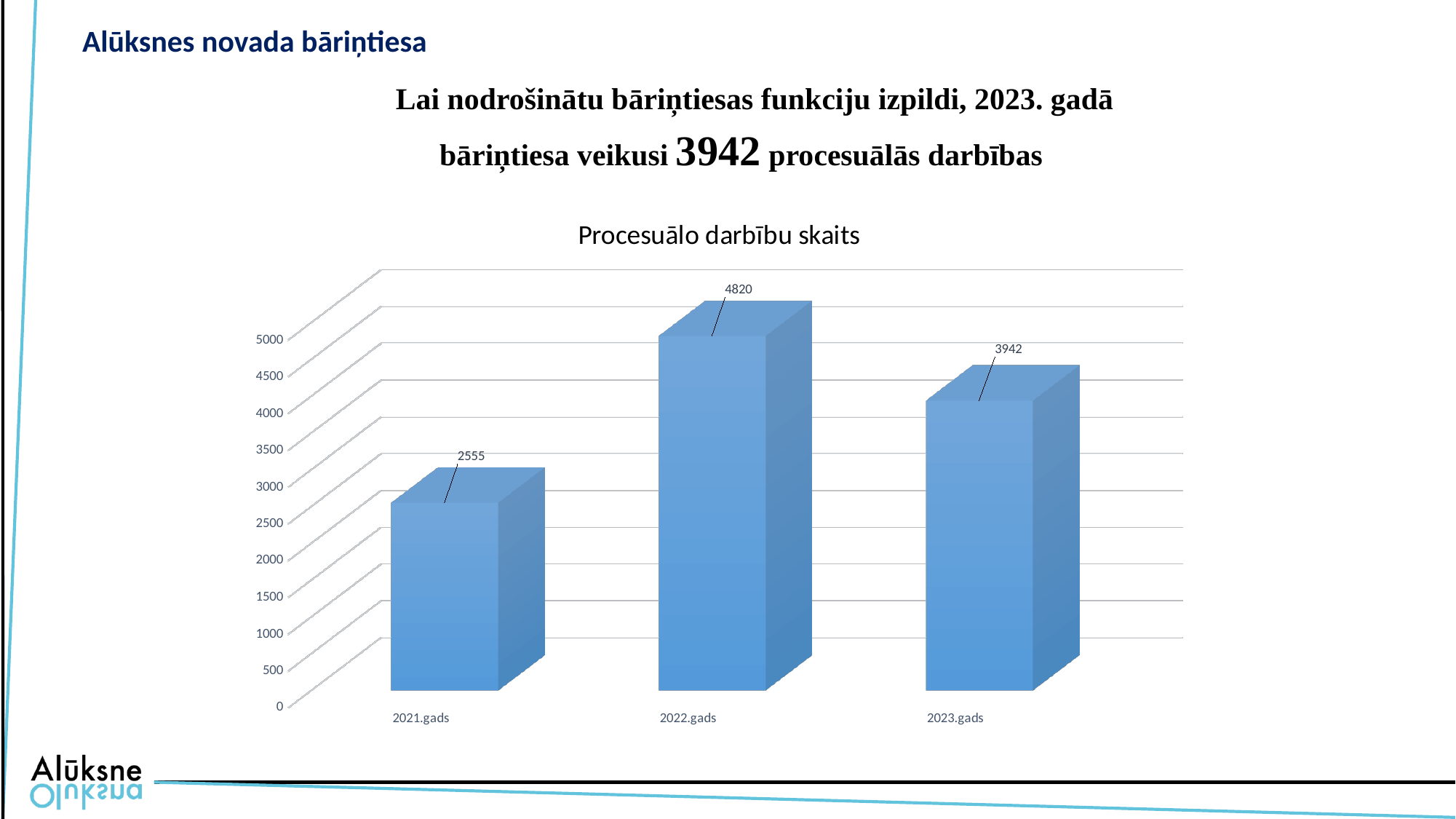
Which year has the highest value? 2022.gads What is the title of the chart? Procesuālo darbību skaits Which is larger, the value for 2021.gads or the value for 2023.gads? 2023.gads What is the difference between the values for 2022.gads and 2023.gads? 878 What is the value for 2023.gads? 3942 What is the value for 2022.gads? 4820 Is the value for 2022.gads greater or less than 4500? greater What kind of chart is shown on the slide? bar chart What is the value for 2021.gads? 2555 What is the difference between the values for 2023.gads and 2021.gads? 1387 Which year has the lowest value? 2021.gads How many years are shown on the chart? 3